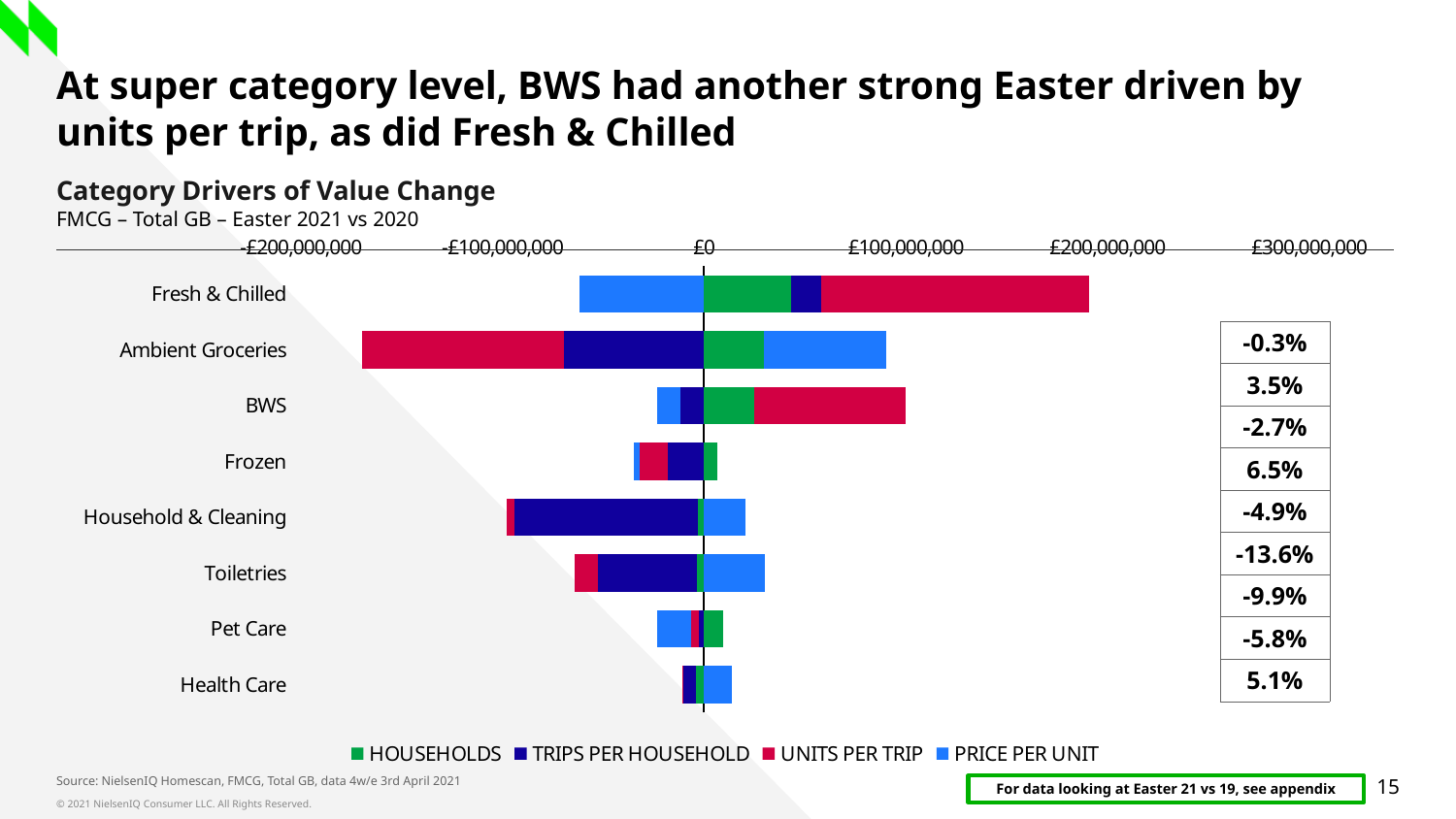
How many series does the legend list? 4 Which category has the largest negative UNITS PER TRIP segment? Ambient Groceries Which category has the largest positive UNITS PER TRIP segment? Fresh & Chilled Which series is shown in red in the legend? UNITS PER TRIP How many categories are plotted on the chart? 8 Which category is listed first (at the top) on the chart? Fresh & Chilled Which category has the larger negative TRIPS PER HOUSEHOLD segment, Household & Cleaning or Toiletries? Household & Cleaning What kind of chart is shown on the slide? Bar chart Is the positive extent of the Fresh & Chilled bar greater or less than £100,000,000? greater What is the title of the chart? Category Drivers of Value Change Is the negative extent of the Ambient Groceries bar greater or less than -£100,000,000 (i.e. further from zero)? greater